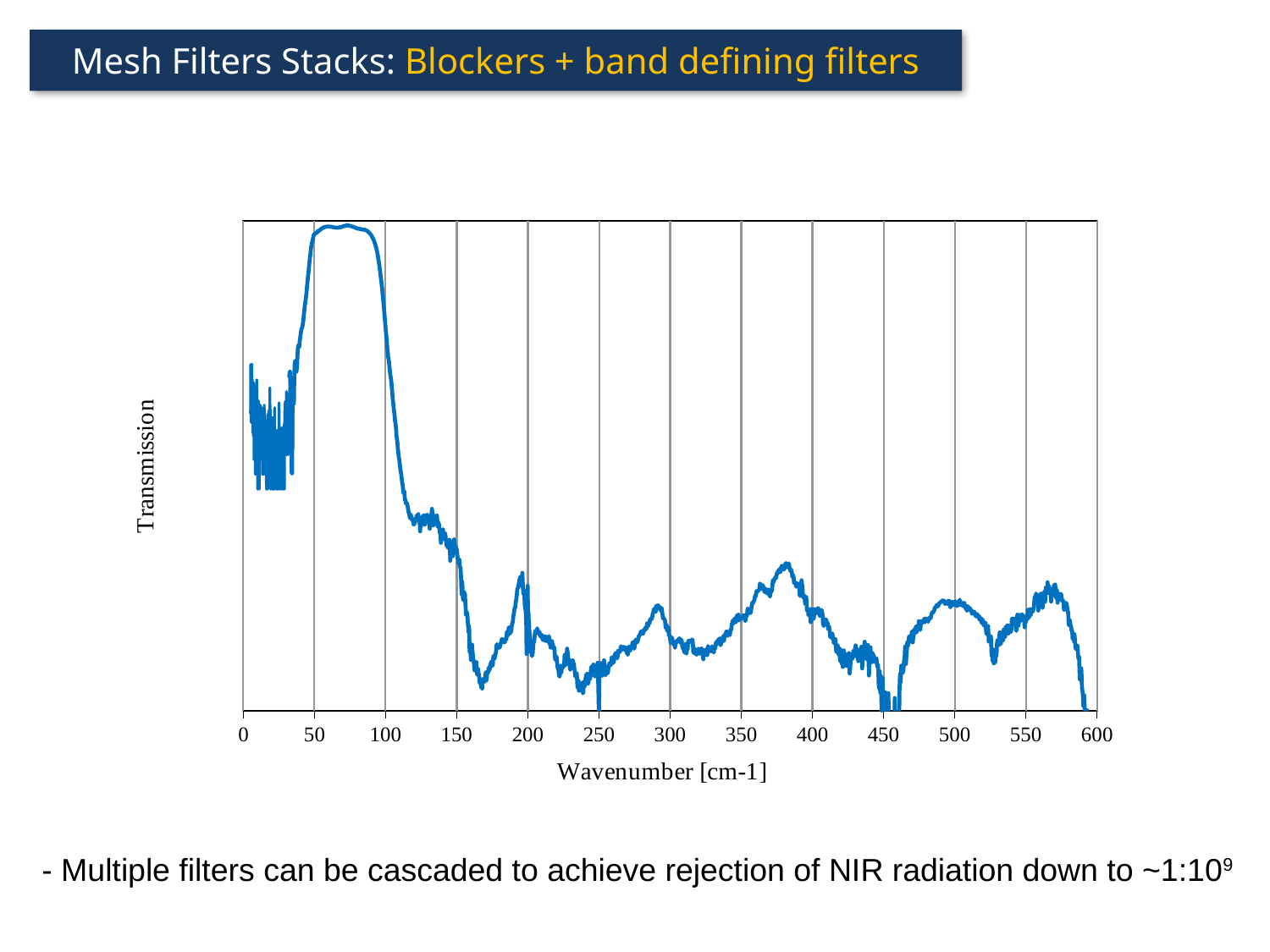
Between which two x-axis tick values does the transmission reach its maximum? between 50 and 100 What is the label of the y axis of the chart? Transmission What is the label of the x axis of the chart? Wavenumber [cm-1] Is the transmission higher at a wavenumber of 75 or at a wavenumber of 300? 75 What kind of chart is shown on the slide? line chart How many lines (data series) are plotted on the chart? 1 Is the transmission higher at a wavenumber of 150 or at a wavenumber of 250? 150 Does the transmission rise or fall as the wavenumber increases from 100 to 150? fall What is the highest wavenumber tick shown on the x axis? 600 Overall, does the transmission rise or fall as the wavenumber increases from 100 to 600? fall What is the spacing between consecutive tick labels on the x axis? 50 Does the transmission rise or fall as the wavenumber increases from 0 to 50? rise